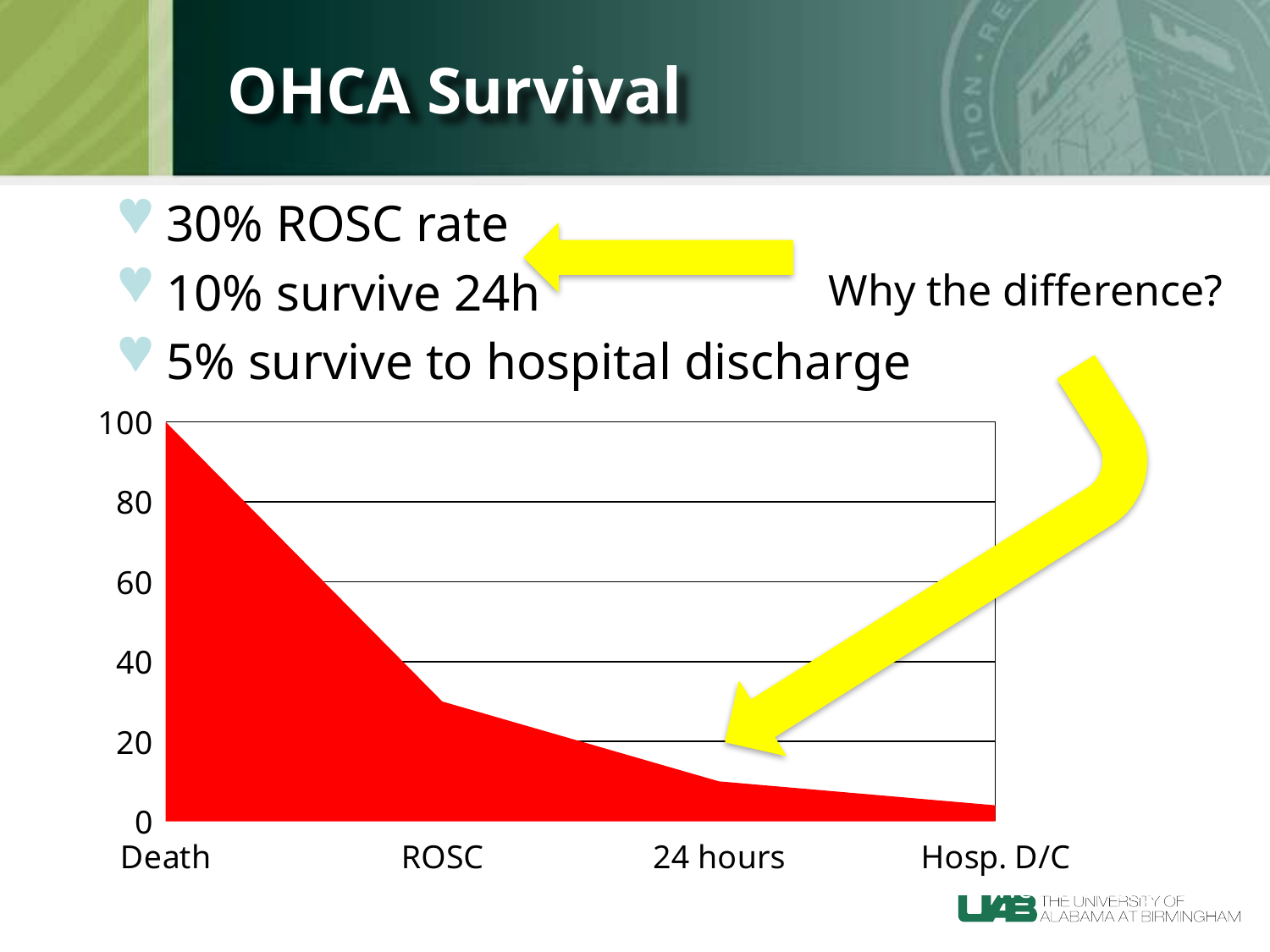
Is the value for ROSC greater or less than 20? greater How many categories are shown along the x axis of the chart? 4 What is the value plotted for Death? 100 Which category has the lowest value in the chart? Hosp. D/C What colour is the filled area in the chart? red Which category has the highest value in the chart? Death Do the values rise or fall moving from Death to Hosp. D/C along the x axis? fall What kind of chart is shown on the slide? area chart Which is larger, the value for ROSC or the value for 24 hours? ROSC Is the value for Hosp. D/C greater or less than 20? less Is the value for 24 hours greater or less than 20? less